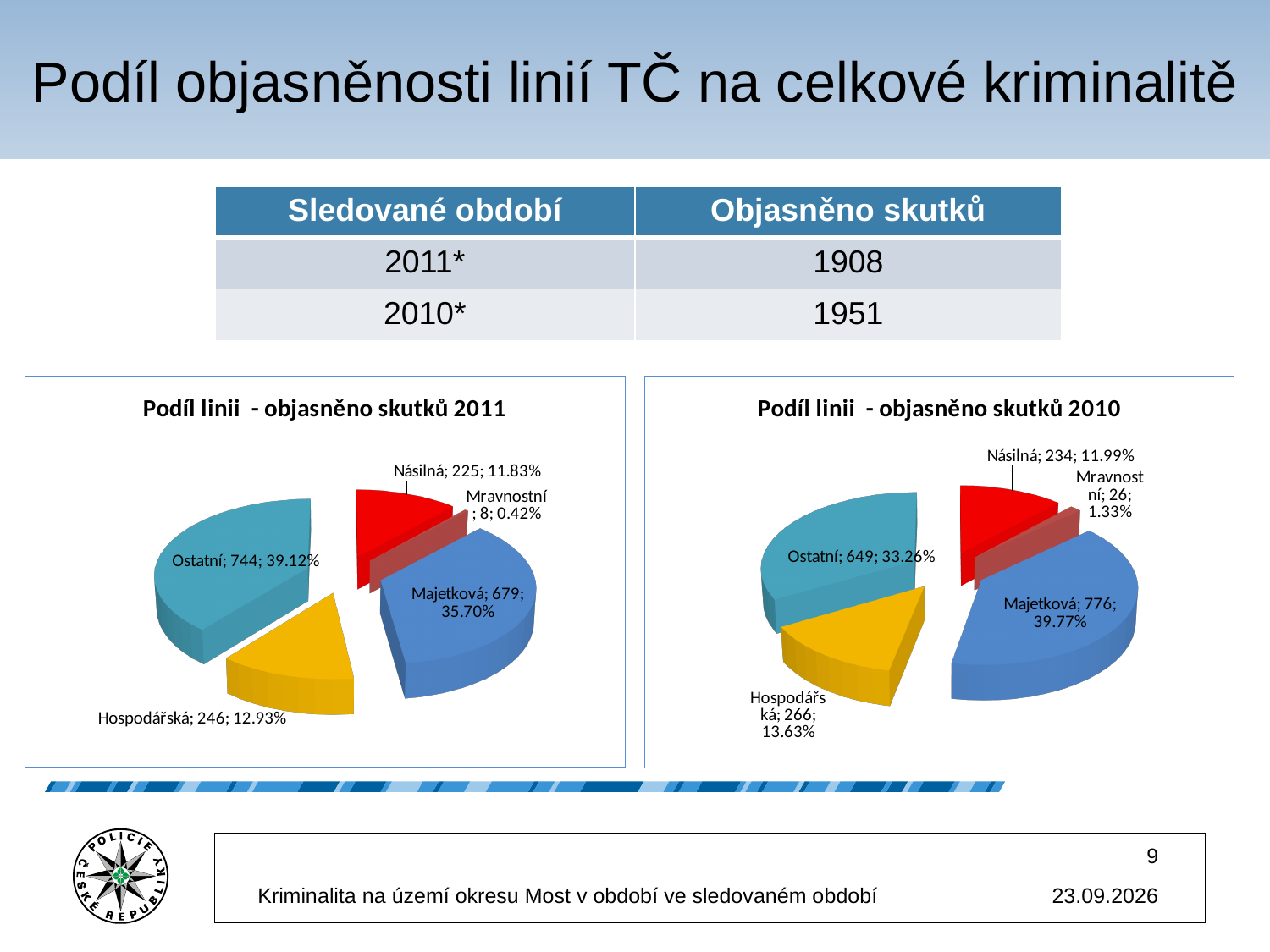
In the chart 'Podíl linii - objasněno skutků 2011', what share of the pie does Ostatní represent? 39.12% What type of chart is used in 'Podíl linii - objasněno skutků 2011'? pie chart In the chart 'Podíl linii - objasněno skutků 2010', which is larger, Násilná or Hospodářská? Hospodářská In the chart 'Podíl linii - objasněno skutků 2011', how many categories are shown? 5 In the chart 'Podíl linii - objasněno skutků 2011', which category has the smallest value? Mravnostní In the chart 'Podíl linii - objasněno skutků 2010', what share of the pie does Majetková represent? 39.77% In the chart 'Podíl linii - objasněno skutků 2011', what is the difference between the values for Ostatní and Majetková? 65 In the chart 'Podíl linii - objasněno skutků 2011', what is the value for Majetková? 679 In the chart 'Podíl linii - objasněno skutků 2011', which category has the largest value? Ostatní In the chart 'Podíl linii - objasněno skutků 2010', what is the difference between the values for Majetková and Ostatní? 127 In the chart 'Podíl linii - objasněno skutků 2010', what is the value for Hospodářská? 266 In the chart 'Podíl linii - objasněno skutků 2010', which category has the largest value? Majetková